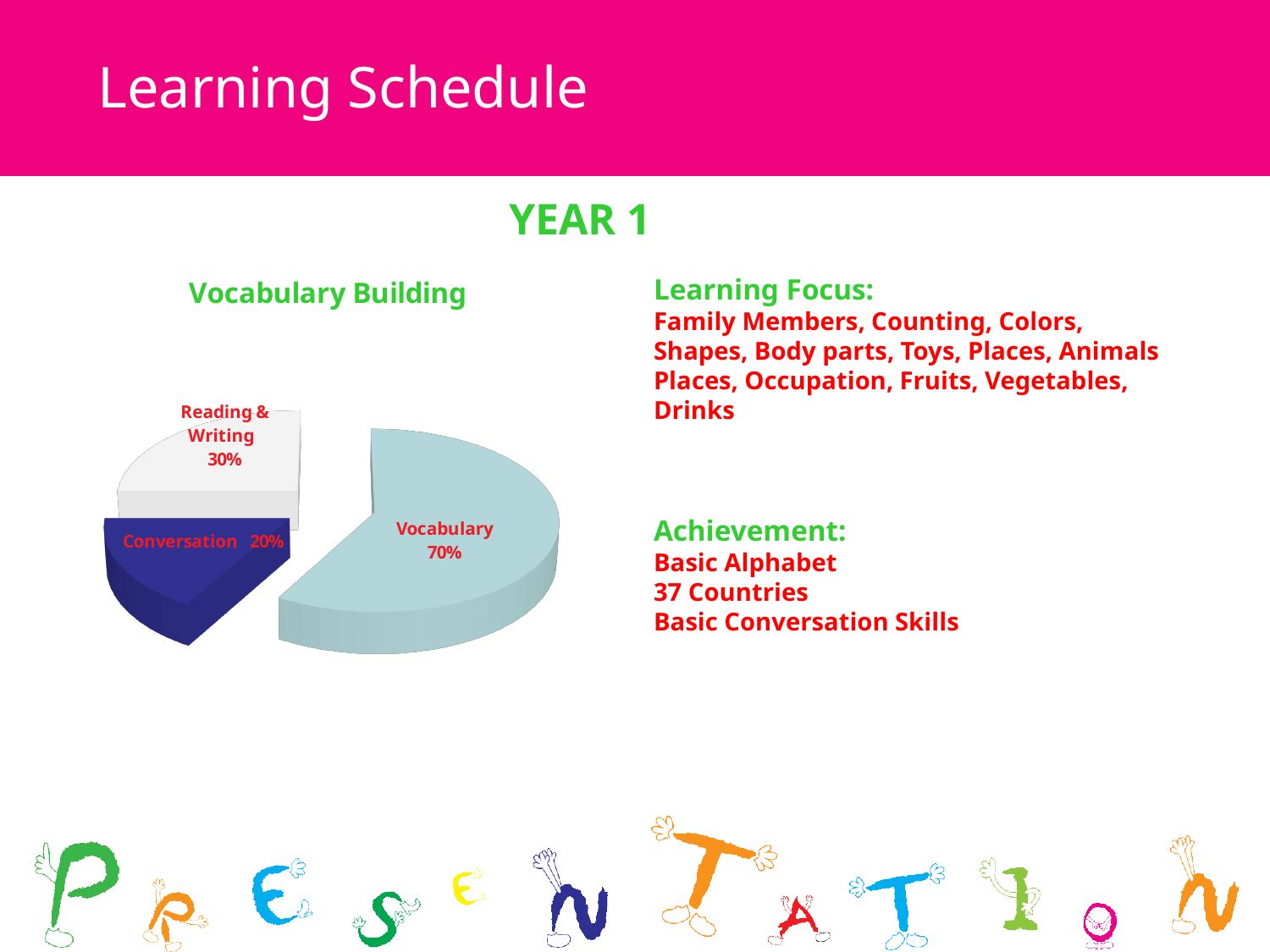
What is the title of the pie chart? Vocabulary Building What is the difference in percentage points between the Reading & Writing slice and the Conversation slice? 10 What kind of chart is shown on the slide? Pie chart Which is larger, the Reading & Writing slice or the Conversation slice? Reading & Writing What percentage is shown for the Reading & Writing slice? 30% What is the difference in percentage points between the Vocabulary slice and the Reading & Writing slice? 40 What colour is the Conversation slice in the pie chart? Dark blue What percentage is shown for the Vocabulary slice? 70% Which slice of the pie chart is the largest? Vocabulary Which slice of the pie chart is the smallest? Conversation How many slices does the pie chart have? 3 What percentage is shown for the Conversation slice? 20%